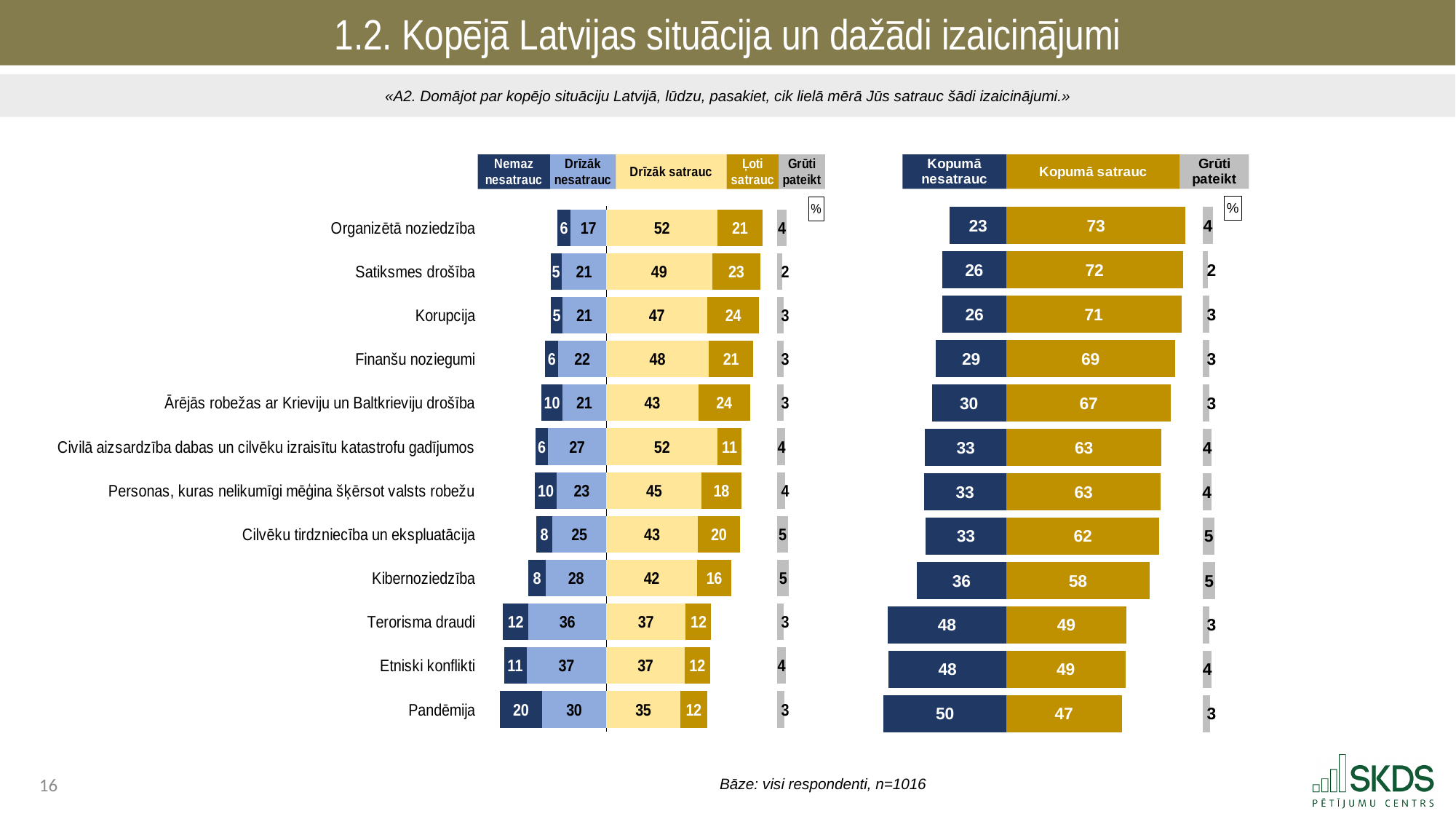
How many series does the legend of the right chart list? 3 In the right chart, which category has the lowest 'Kopumā satrauc' value? Pandēmija What type of chart is the right chart? Stacked bar chart In the right chart, which category has the highest 'Kopumā satrauc' value? Organizētā noziedzība In the right chart, what is the 'Kopumā satrauc' value for Kibernoziedzība? 58 In the right chart, what is the combined total of 'Kopumā nesatrauc' and 'Kopumā satrauc' for Satiksmes drošība? 98 In the left chart, which is larger: the 'Drīzāk nesatrauc' value for Etniski konflikti or for Terorisma draudi? Etniski konflikti In the right chart, what is the difference between the 'Kopumā nesatrauc' values for Pandēmija and Organizētā noziedzība? 27 In the left chart, what is the 'Ļoti satrauc' value for Korupcija? 24 How many series does the legend of the left chart list? 5 How many categories are shown in the left chart? 12 In the left chart, what is the 'Nemaz nesatrauc' value for Pandēmija? 20